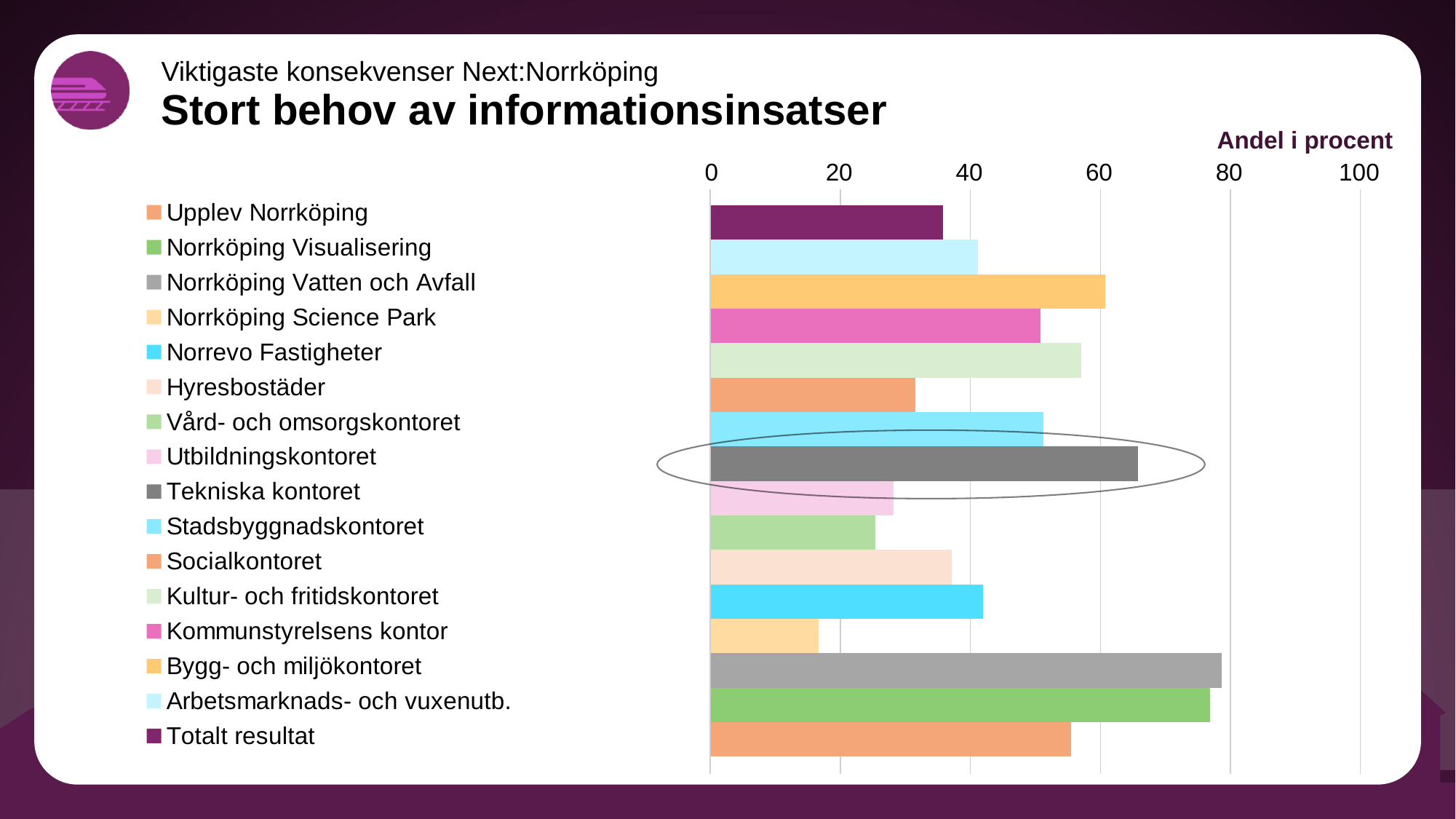
How many bars are plotted in the chart? 16 Is the value for Tekniska kontoret greater or less than 60? greater Which entry has the lowest value in the chart? Norrköping Science Park Is the value for Totalt resultat greater or less than 40? less Is the value for Norrköping Science Park greater or less than 20? less What label is shown above the horizontal axis of the chart? Andel i procent Which is larger, the value for Bygg- och miljökontoret or the value for Socialkontoret? Bygg- och miljökontoret Which is larger, the value for Tekniska kontoret or the value for Totalt resultat? Tekniska kontoret What kind of chart is shown on the slide? bar chart How many entries does the legend list? 16